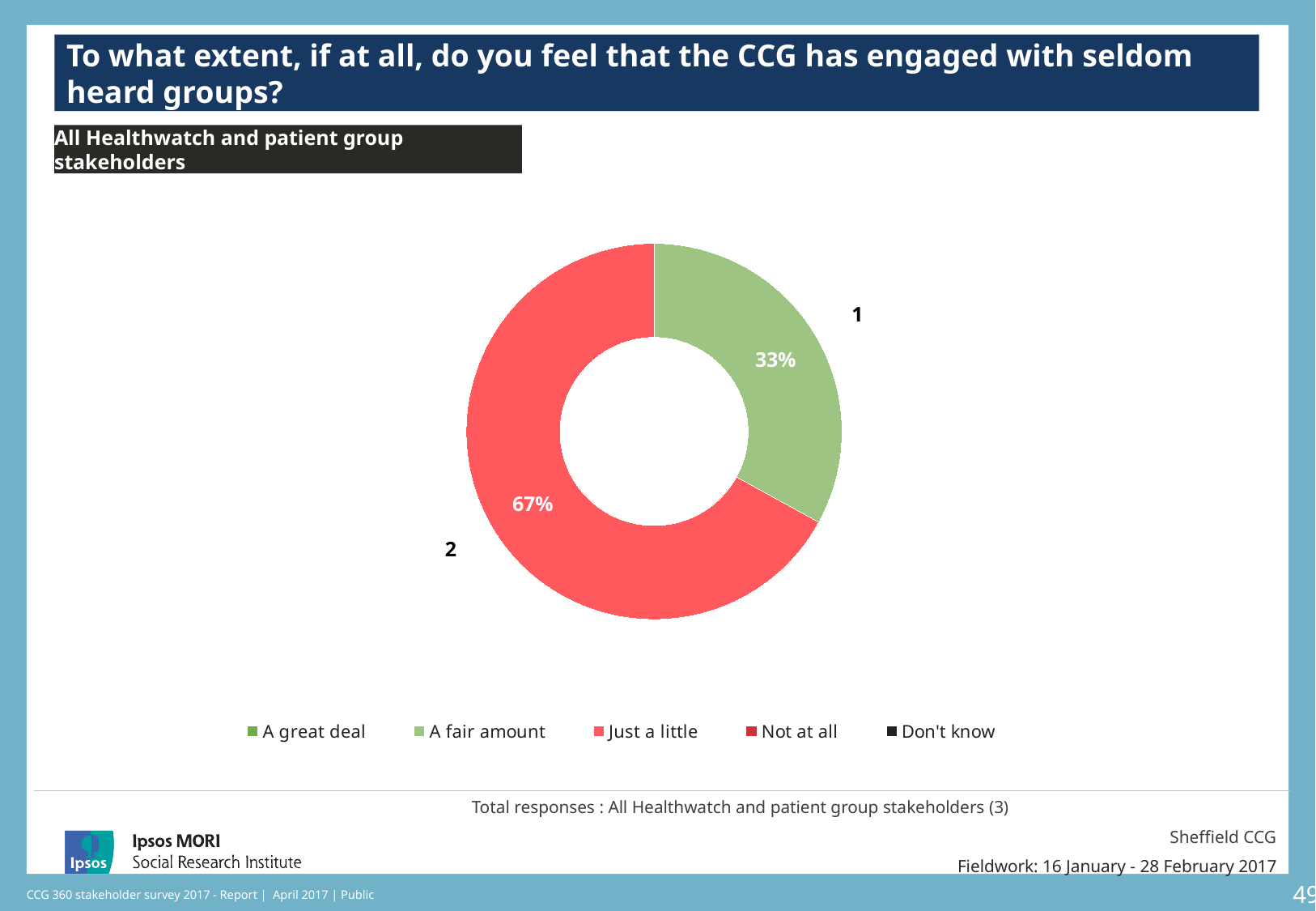
How many respondents are shown next to the 'Just a little' slice? 2 What is the difference in percentage points between 'Just a little' and 'A fair amount'? 34 percentage points What percentage of respondents said 'A fair amount'? 33% What is the total number of responses stated below the chart? 3 Which response category has the largest share of the chart? Just a little What percentage of respondents said 'Just a little'? 67% What colour is the 'Just a little' slice in the chart? Red Which of the two plotted response categories has the smaller share? A fair amount How many slices with non-zero values are plotted in the chart? 2 How many response categories does the legend list? 5 What kind of chart is shown on the slide? Donut (pie) chart Which is larger: the share for 'Just a little' or the share for 'A fair amount'? Just a little